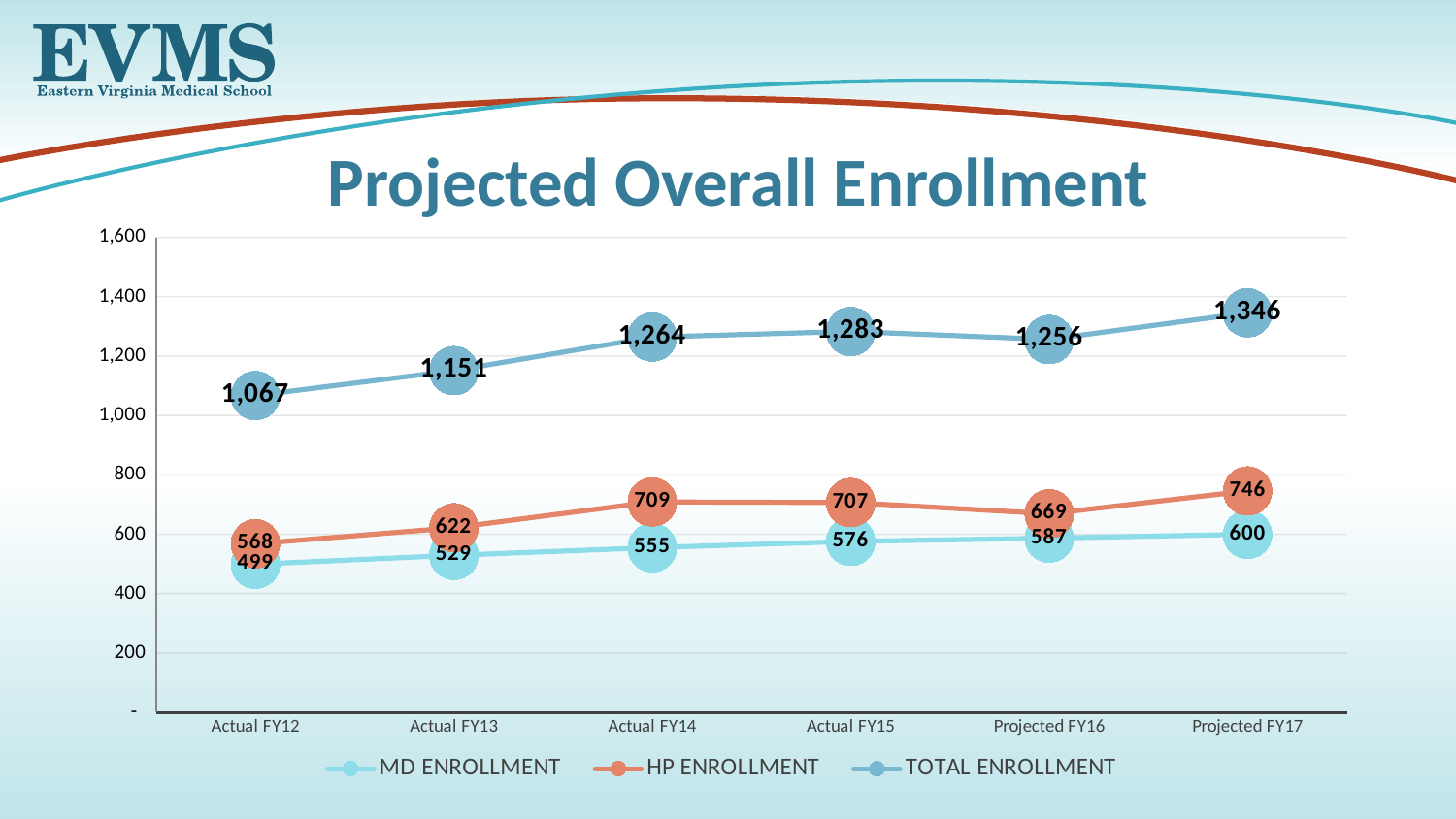
Which is larger, HP ENROLLMENT for Actual FY15 or HP ENROLLMENT for Projected FY16? Actual FY15 Which category has the lowest HP ENROLLMENT? Actual FY12 What is the difference between TOTAL ENROLLMENT for Projected FY17 and Actual FY12? 279 What kind of chart is shown on the slide? line chart What is the MD ENROLLMENT value for Actual FY12? 499 How many series does the legend list? 3 How many categories are shown on the x axis? 6 Is the TOTAL ENROLLMENT value for Actual FY13 greater or less than 1,200? less Does MD ENROLLMENT rise or fall from Actual FY12 to Projected FY17? rise What is the HP ENROLLMENT value for Actual FY14? 709 Which category has the highest TOTAL ENROLLMENT? Projected FY17 What is the TOTAL ENROLLMENT value for Projected FY17? 1,346